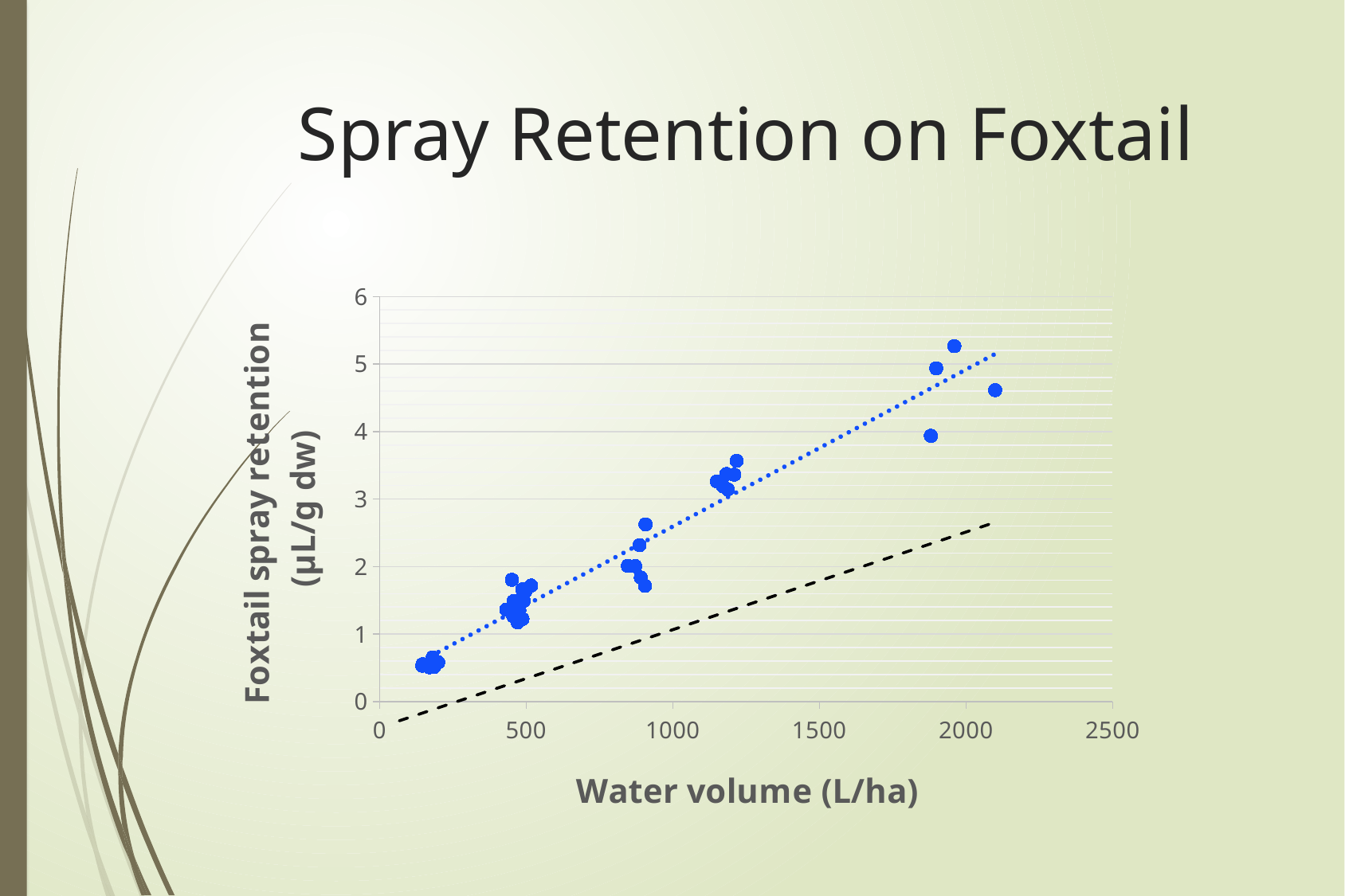
Is the highest plotted spray retention value greater or less than 5? greater Are the spray retention values for the points near 150 L/ha greater or less than 1? less Which group of points has higher spray retention: those near 2000 L/ha or those near 500 L/ha? those near 2000 L/ha What is the label of the x axis? Water volume (L/ha) Do the plotted values of foxtail spray retention rise or fall as water volume increases? rise Are the spray retention values for the points near 1200 L/ha greater or less than 3? greater What kind of chart is shown on the slide? scatter chart What is the title of the chart on the slide? Spray Retention on Foxtail What is the maximum value shown on the y axis? 6